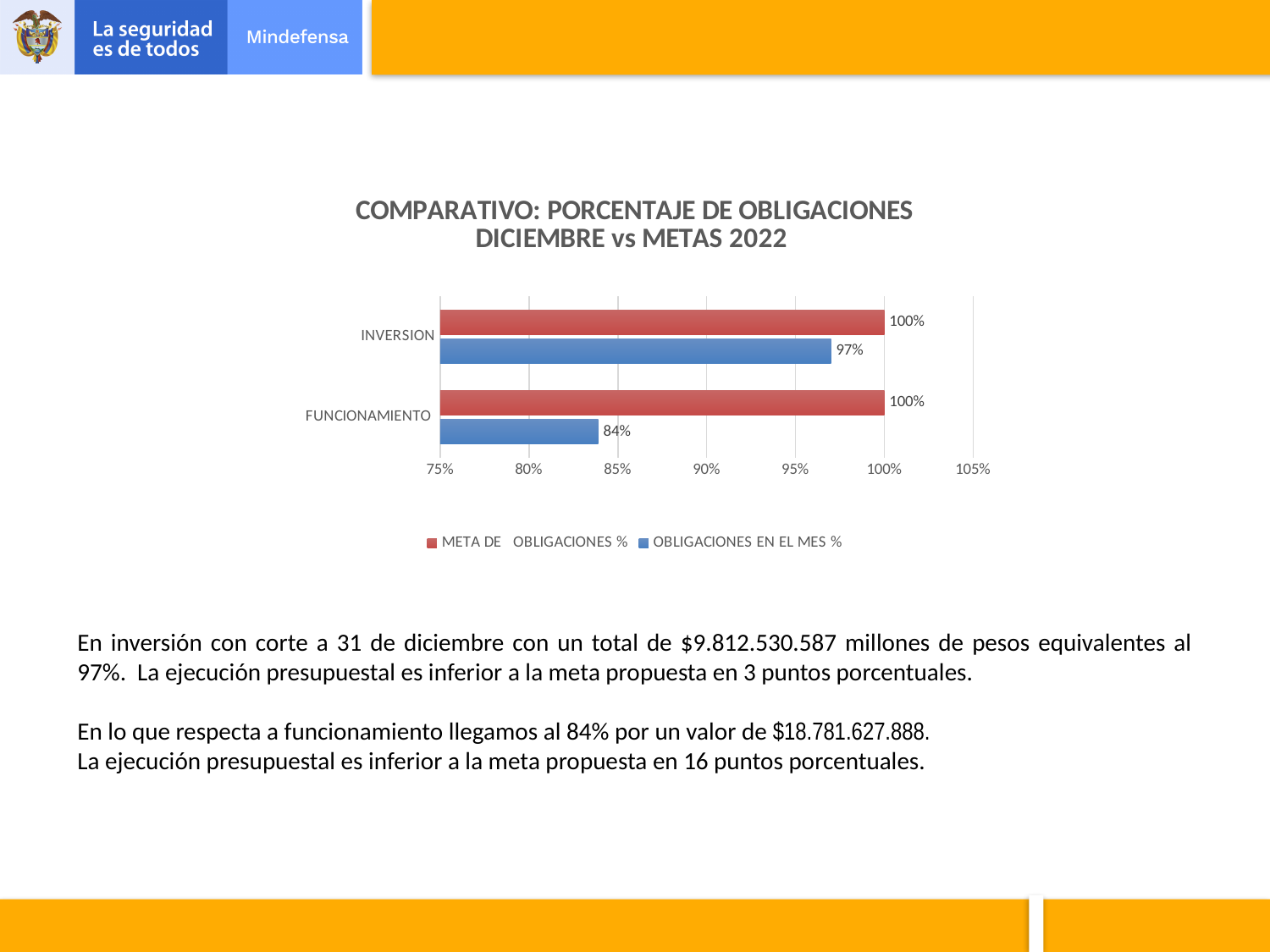
How many series does the legend list? 2 What is the META DE OBLIGACIONES % for INVERSION? 100% Which is larger: the OBLIGACIONES EN EL MES % for INVERSION or for FUNCIONAMIENTO? INVERSION Which category has the highest OBLIGACIONES EN EL MES % value? INVERSION What is the value of OBLIGACIONES EN EL MES % for FUNCIONAMIENTO? 84% What is the difference between the META DE OBLIGACIONES % and the OBLIGACIONES EN EL MES % for FUNCIONAMIENTO? 16 percentage points How many categories are shown on the chart? 2 What is the difference between the META DE OBLIGACIONES % and the OBLIGACIONES EN EL MES % for INVERSION? 3 percentage points What is the META DE OBLIGACIONES % for FUNCIONAMIENTO? 100% What is the value of OBLIGACIONES EN EL MES % for INVERSION? 97% What kind of chart is shown on the slide? Bar chart Which category has the lowest OBLIGACIONES EN EL MES % value? FUNCIONAMIENTO